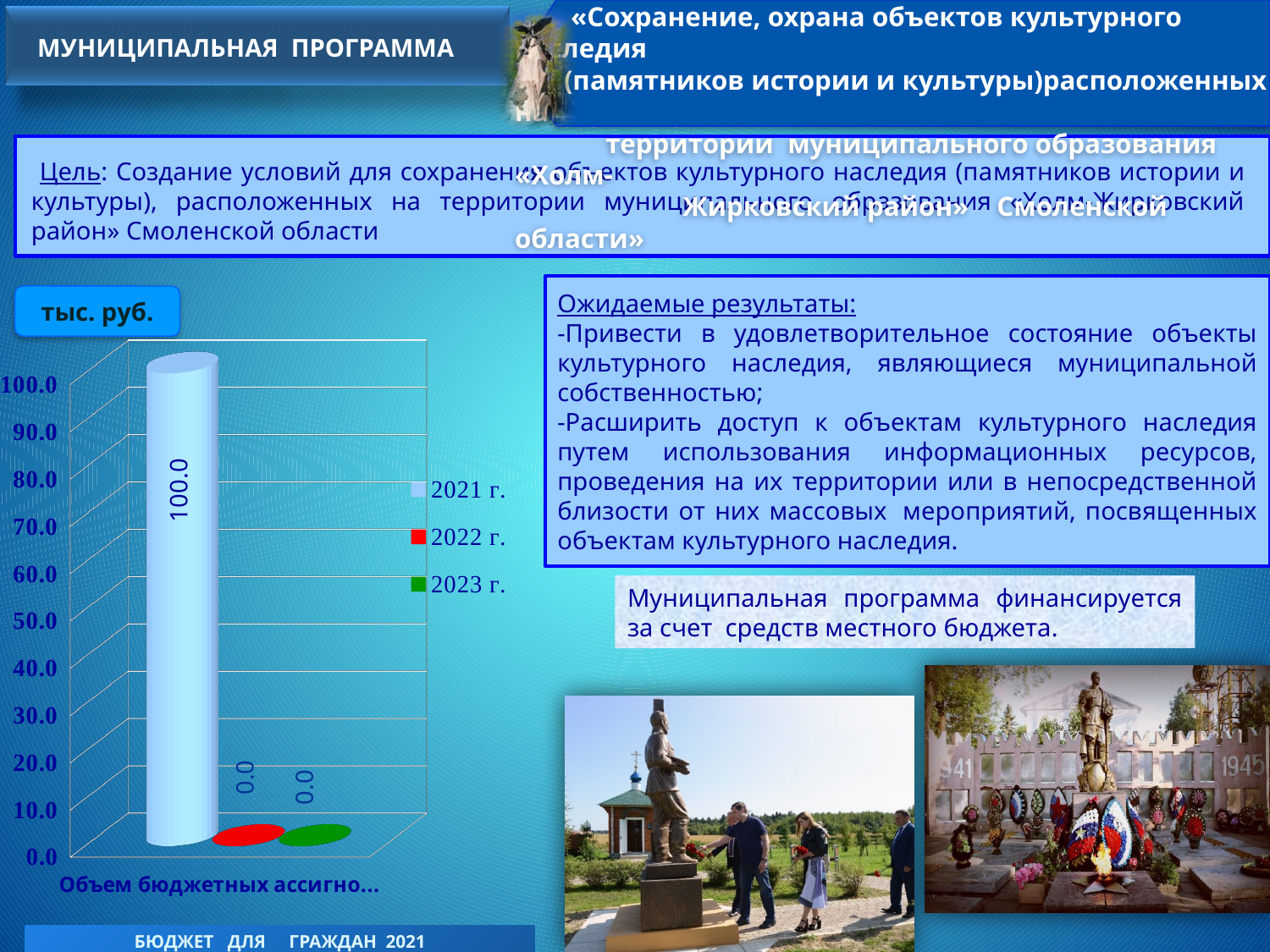
What colour represents 2022 г. in the chart legend? red What unit is shown in the label above the chart? тыс. руб. What is the difference between the values for 2021 г. and 2022 г.? 100.0 Which is larger, the value for 2021 г. or the value for 2023 г.? 2021 г. Do the values rise or fall from 2021 г. to 2023 г.? fall What is the value for 2023 г. on the chart? 0.0 How many series does the chart legend list? 3 What kind of chart is shown on the slide? bar chart Is the value for 2021 г. greater or less than 50.0? greater What is the value for 2022 г. on the chart? 0.0 Which year has the highest value on the chart? 2021 г. What is the value for 2021 г. on the chart? 100.0